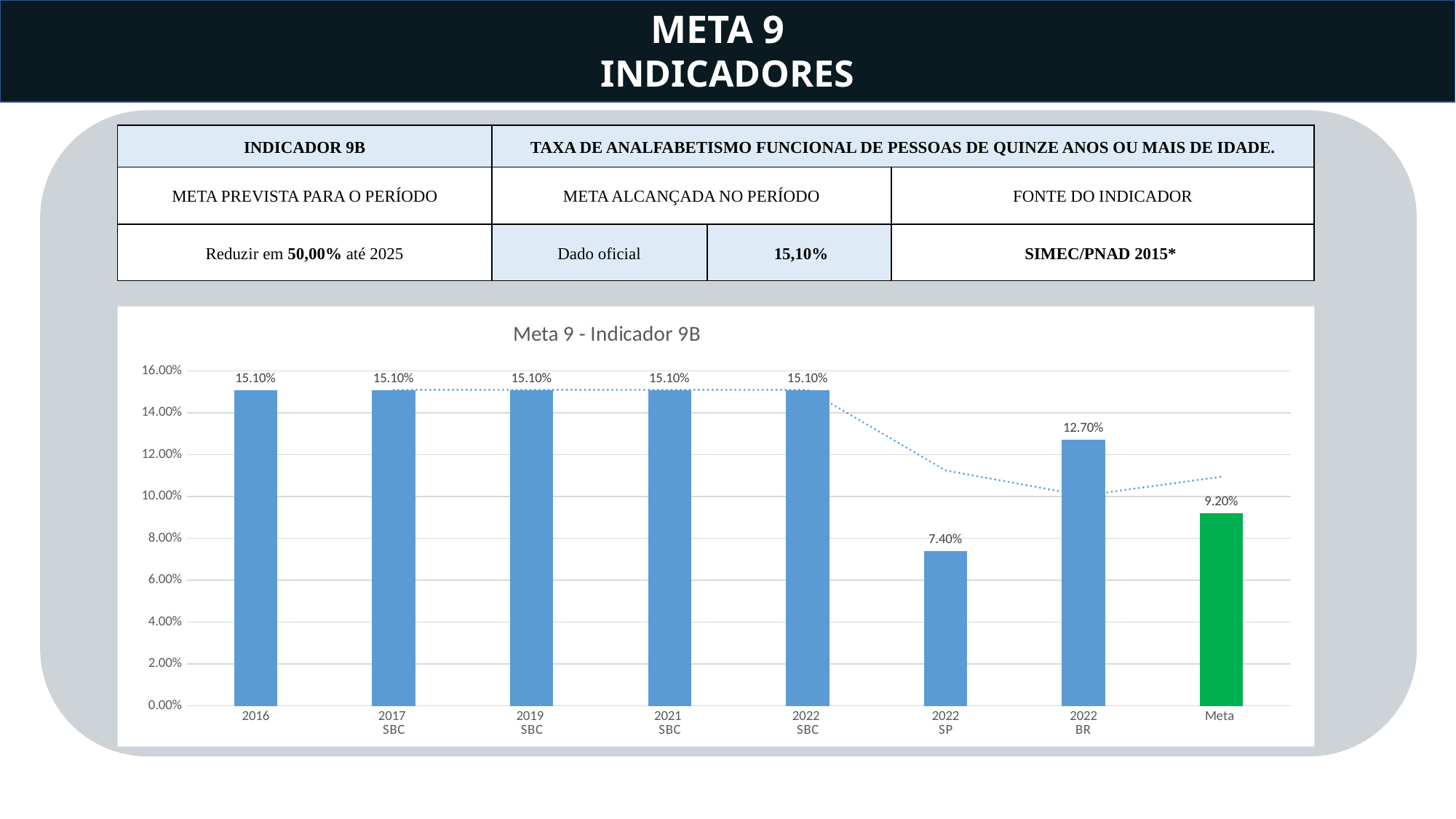
What kind of chart is shown on the slide? Bar chart Is the value for 2022 SP greater or less than 8.00%? less What is the value for 2016 in the chart? 15.10% What is the value for 2022 SP in the Meta 9 - Indicador 9B chart? 7.40% Which category has the lowest value in the chart? 2022 SP What is the difference between the 2022 SBC value and the Meta value? 5.90% What is the title of the chart? Meta 9 - Indicador 9B What is the value of the Meta bar in the chart? 9.20% How many bars are plotted in the chart? 8 Which is larger, the value for 2022 BR or the value for Meta? 2022 BR What is the value for 2022 BR in the chart? 12.70% What is the difference between the 2022 BR value and the 2022 SP value? 5.30%